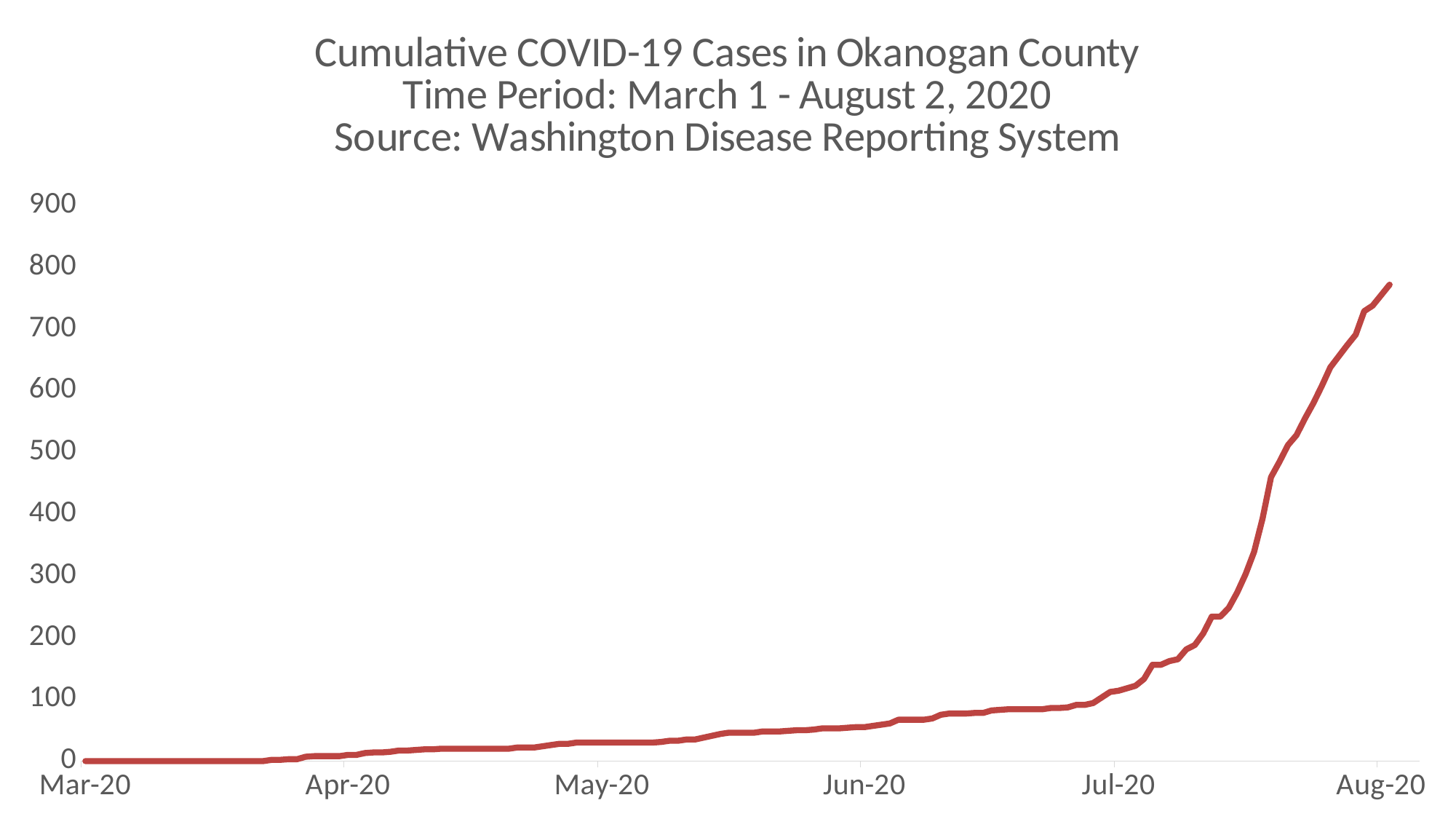
Is the value at Apr-20 greater or less than 100? less Which of the labelled months, Jun-20 or Jul-20, has the higher cumulative case value? Jul-20 Is the value at May-20 greater or less than 100? less What is the source of the data named in the chart title? Washington Disease Reporting System What is the highest tick value shown on the y axis? 900 At which labelled month on the x axis is the cumulative case count highest? Aug-20 At which labelled month on the x axis is the cumulative case count lowest? Mar-20 Is the value at Aug-20 greater or less than 800? less Do the cumulative case values rise or fall from Mar-20 to Aug-20? Rise What kind of chart is shown on the slide? Line chart